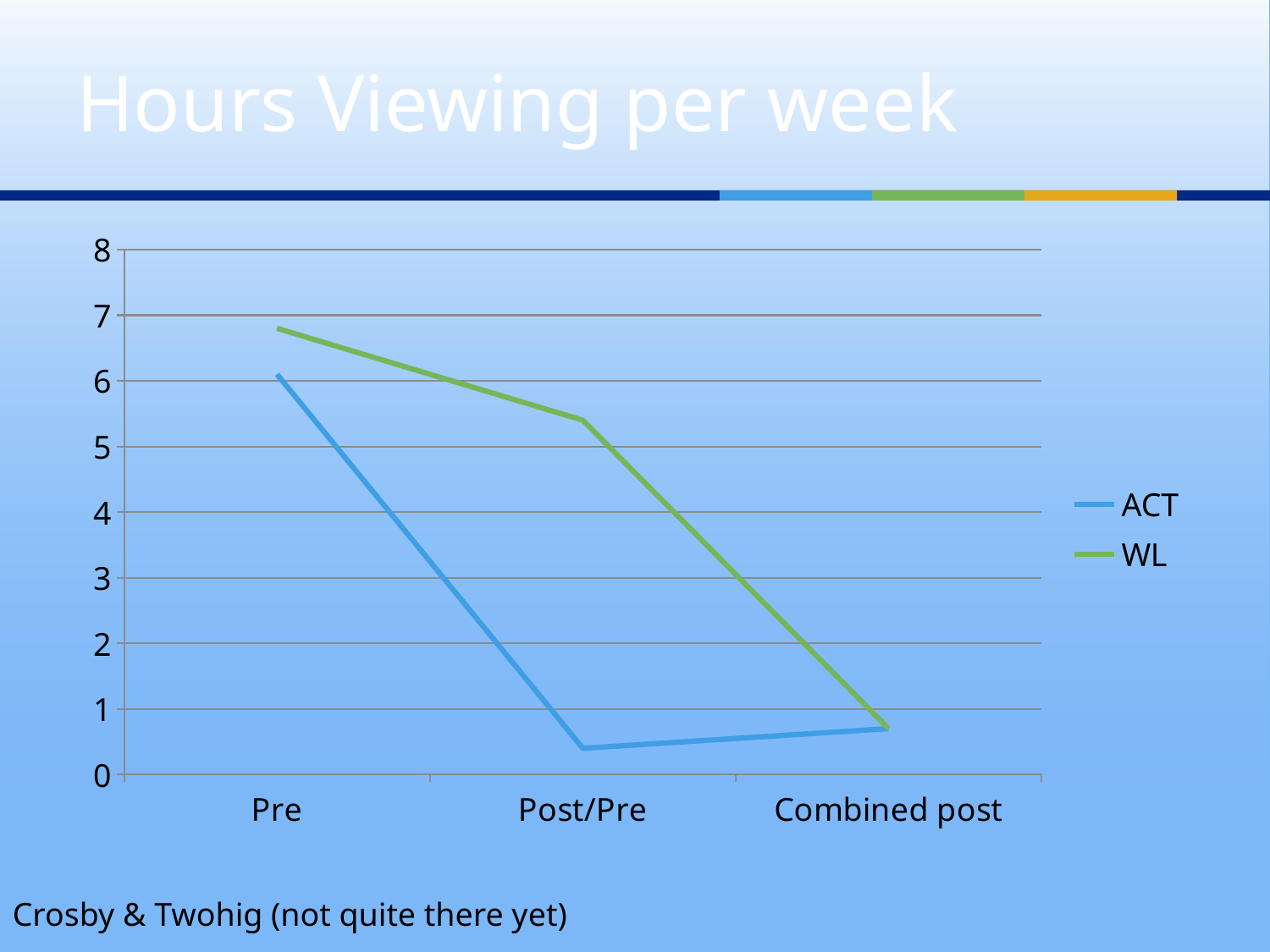
Is the value for ACT at Post/Pre greater or less than 1? less How many series does the legend list? 2 How many categories are shown on the x axis? 3 At Pre, which series has the higher value, ACT or WL? WL What is the title of the chart? Hours Viewing per week Is the value for ACT at Pre greater or less than 5? greater At Post/Pre, which series has the higher value, ACT or WL? WL At which category does the WL series reach its highest value? Pre Is the value for WL at Combined post greater or less than 2? less What kind of chart is shown on the slide? line chart Do the values for the WL series rise or fall from Pre to Combined post? fall